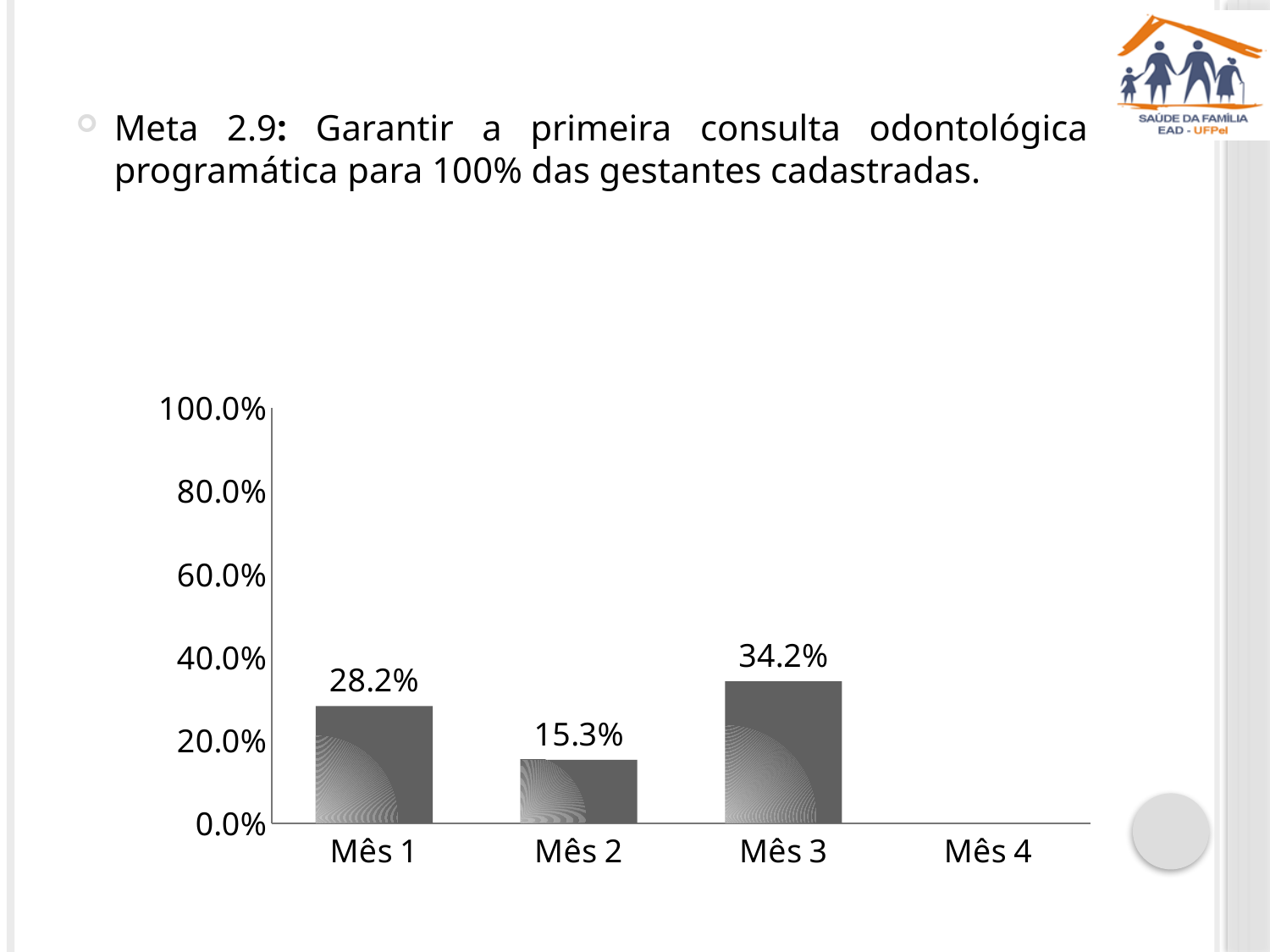
What is the difference between the values for Mês 3 and Mês 1? 6.0% What is the value for Mês 2? 15.3% What is the value for Mês 1? 28.2% Is the value for Mês 3 greater or less than 40.0%? less Does the value rise or fall from Mês 2 to Mês 3? rise Which month has the highest value among the bars shown? Mês 3 Which month has the lowest value among the bars with a data label? Mês 2 Which is larger, the value for Mês 1 or the value for Mês 2? Mês 1 What is the value for Mês 3? 34.2% What is the difference between the values for Mês 1 and Mês 2? 12.9% How many categories are shown on the x axis? 4 What kind of chart is shown on the slide? bar chart